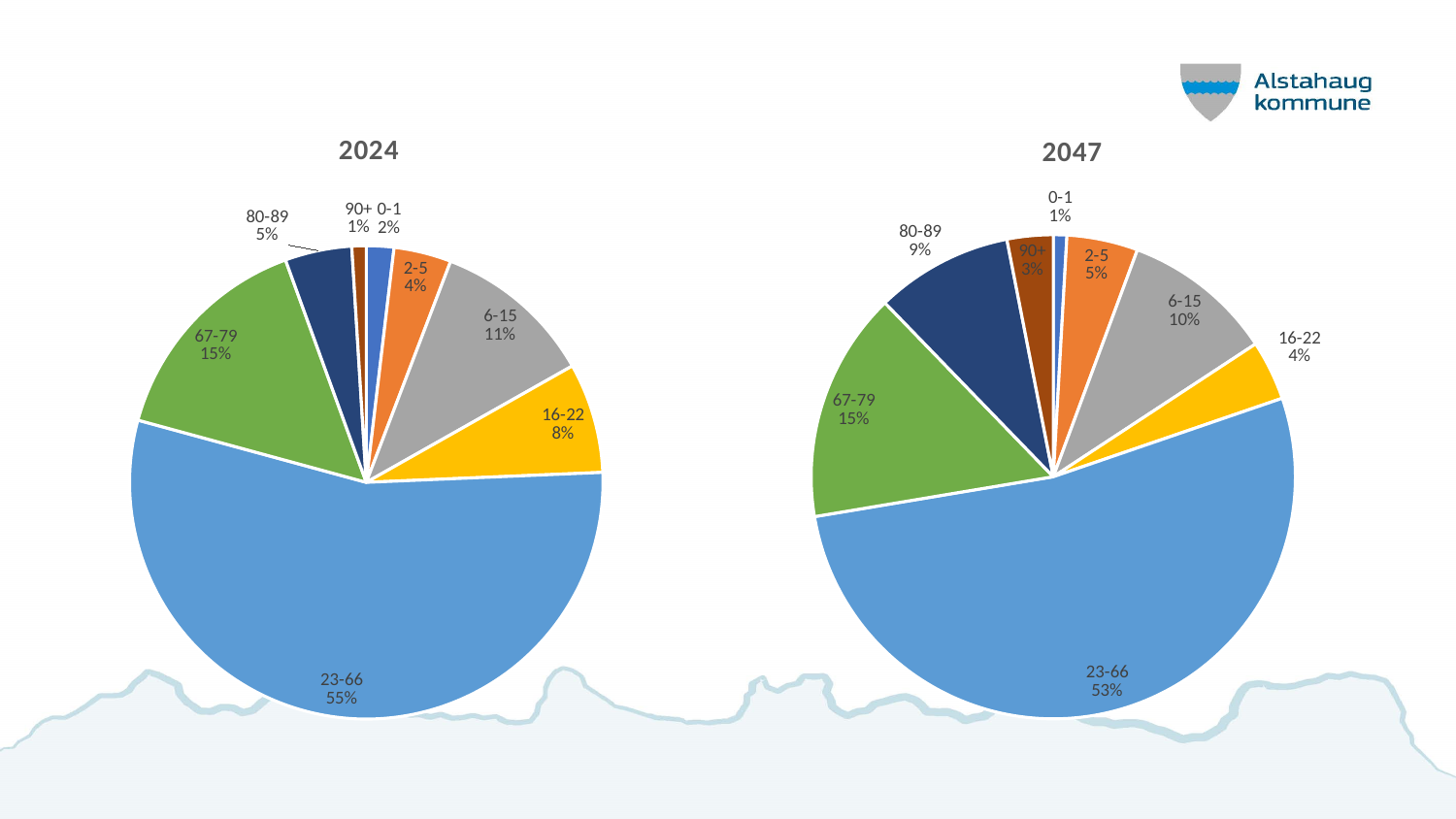
In the 2047 pie chart, what share does the 90+ age group have? 3% How many slices does the 2024 pie chart have? 8 In the 2024 pie chart, what share does the 23-66 age group have? 55% What is the difference between the 16-22 share in the 2024 chart and the 16-22 share in the 2047 chart? 4% What is the title of the chart on the right? 2047 In the 2047 pie chart, what share does the 80-89 age group have? 9% In the 2047 pie chart, what share does the 23-66 age group have? 53% In the 2024 pie chart, which age group has the largest share? 23-66 What type of chart is used on this slide? Pie chart Which is larger: the 80-89 share in the 2024 chart or the 80-89 share in the 2047 chart? 2047 In the 2024 pie chart, what share does the 6-15 age group have? 11% In the 2047 pie chart, which age group has the smallest share? 0-1